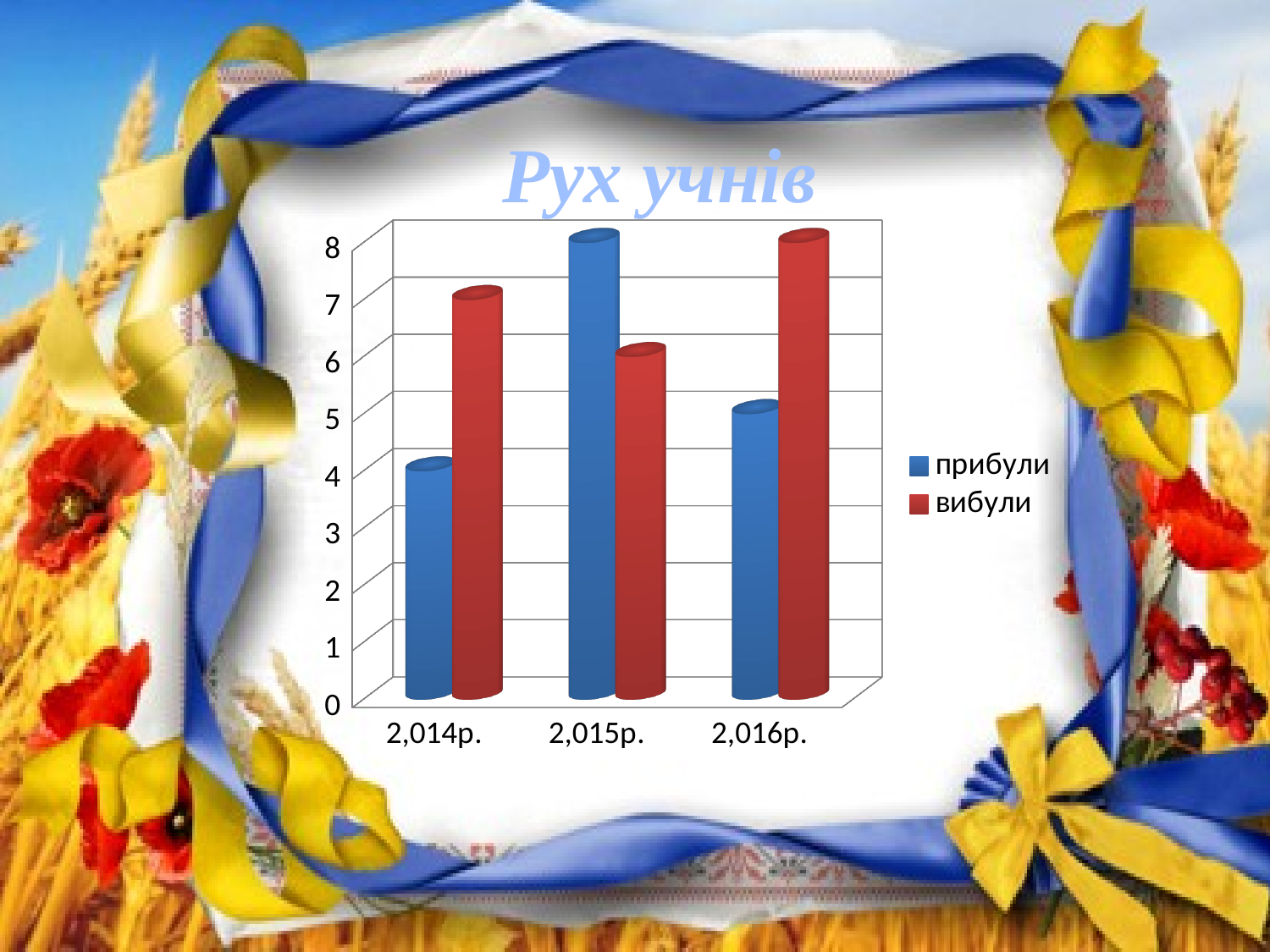
What is the value for прибули in 2,015р.? 8 What kind of chart is shown on the slide? bar chart What is the title of the chart? Рух учнів What is the value for прибули in 2,014р.? 4 Which is larger in 2,015р., прибули or вибули? прибули In which year is the value for прибули lowest? 2,014р. Is the value for вибули in 2,016р. greater or less than 6? greater In which year is the value for прибули highest? 2,015р. How many categories are shown on the x axis? 3 What is the value for вибули in 2,014р.? 7 Which series is shown in red? вибули How many series does the legend list? 2